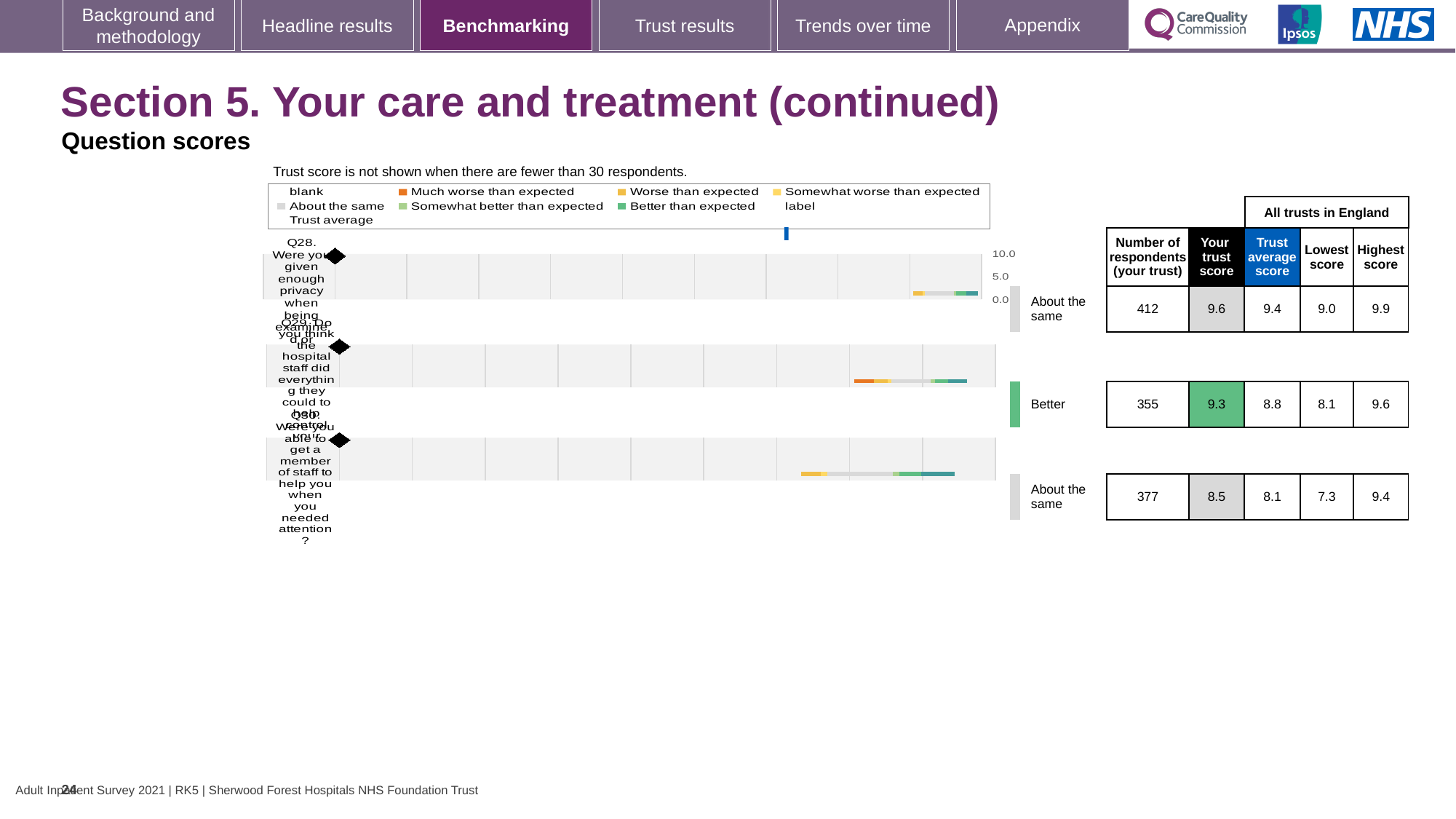
For Q30, which is larger: the trust score or the trust average score? the trust score How many questions (categories) are plotted in the chart? 3 How many respondents answered Q29 (staff did everything to help control pain)? 355 Which question has the lowest trust score? Q30 What benchmark category is shown for Q29? Better What kind of chart is used to show the question scores on this slide? bar chart What is the highest score across all trusts in England for Q28? 9.9 What is the difference between the trust score and the trust average score for Q29? 0.5 What is the maximum value shown on the score axis of the chart? 10.0 Which question has the highest trust score? Q28 What is the lowest score across all trusts in England for Q30 (getting a member of staff to help when needed)? 7.3 What is the trust score for Q28 (privacy when being examined or treated)? 9.6